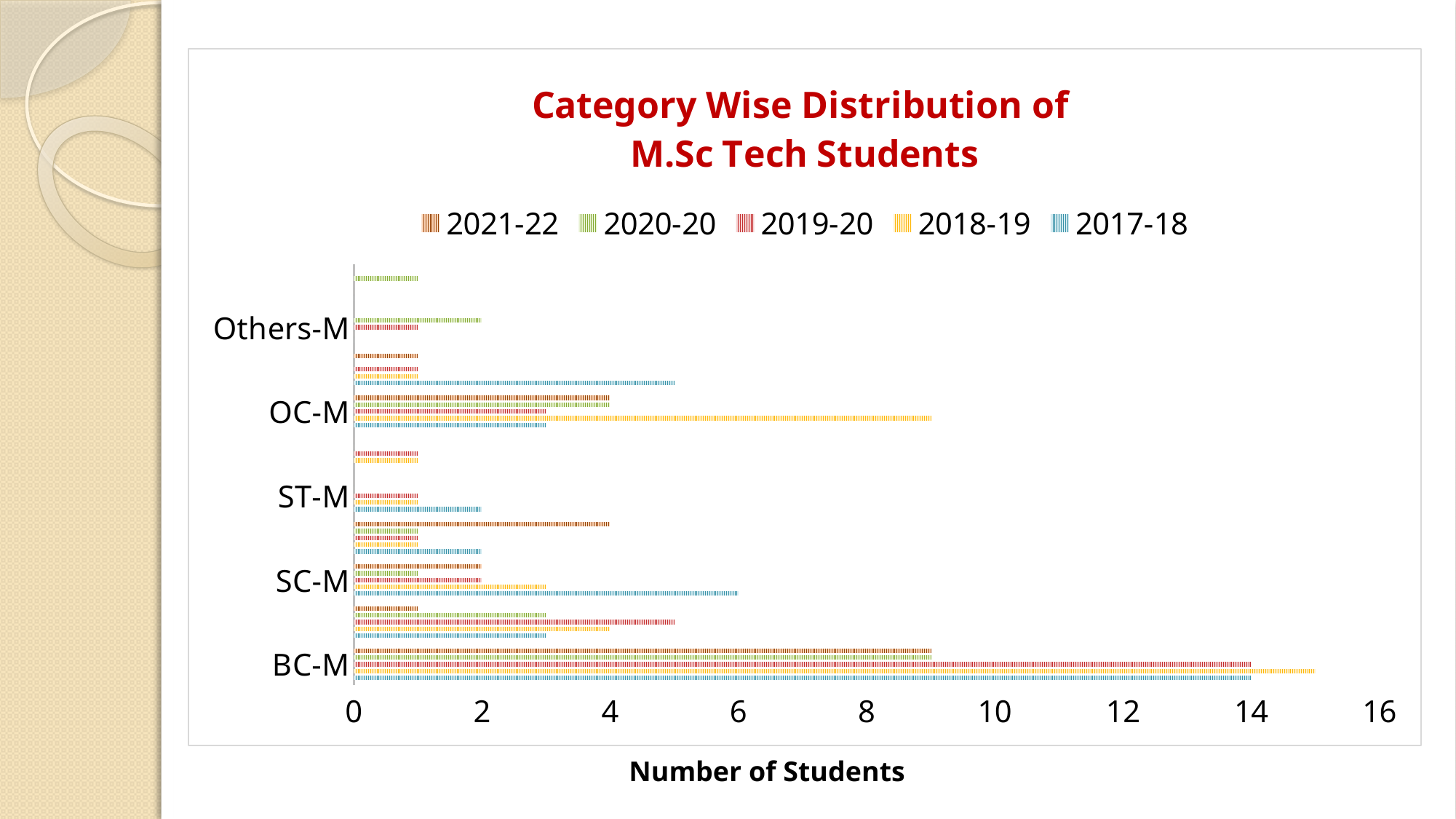
What is the 2021-22 value for OC-M? 4 What is the difference between the 2017-18 value for BC-M and the 2017-18 value for SC-M? 8 Is the 2018-19 value for OC-M greater or less than 8? greater How many series does the legend list? 5 What is the 2017-18 value for ST-M? 2 What is the 2019-20 value for BC-M? 14 Which is larger, the 2017-18 value for SC-M or the 2017-18 value for OC-M? SC-M What is the x-axis title of the chart? Number of Students What is the title of the chart? Category Wise Distribution of M.Sc Tech Students What kind of chart is shown on the slide? bar chart Which category has the highest 2018-19 value? BC-M What is the 2017-18 value for SC-M? 6